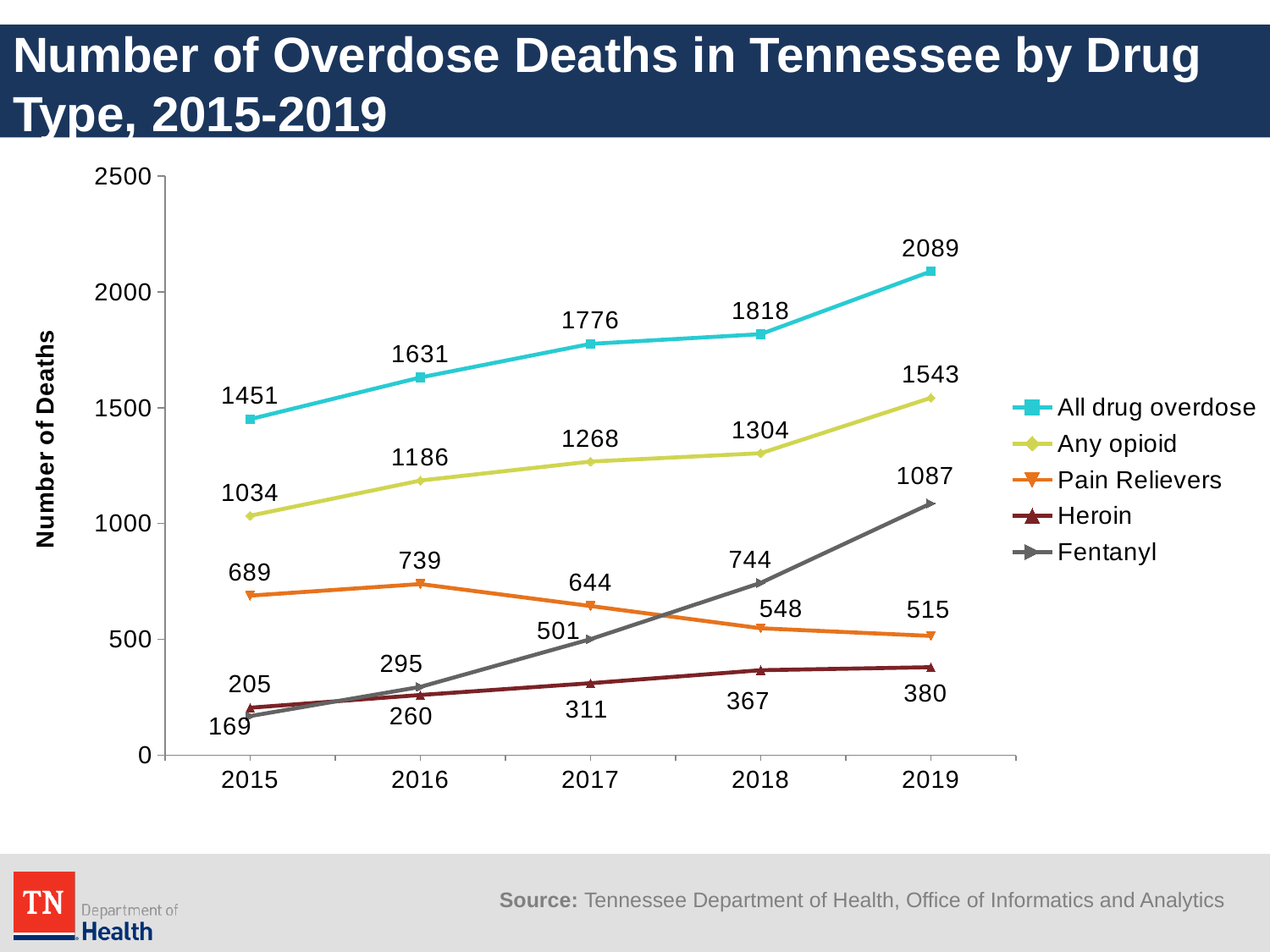
How many years are plotted along the x axis? 5 What was the number of heroin overdose deaths in 2015? 205 What type of chart is shown on the slide? Line chart What is the difference between any opioid deaths and pain reliever deaths in 2018? 756 What was the number of all drug overdose deaths in 2019? 2089 How many series does the legend list? 5 By how much did all drug overdose deaths increase from 2015 to 2019? 638 In which year were fentanyl overdose deaths lowest? 2015 In which year were pain reliever overdose deaths highest? 2016 Do fentanyl overdose deaths rise or fall from 2015 to 2019? Rise What was the number of fentanyl overdose deaths in 2017? 501 Which had more overdose deaths in 2019, pain relievers or heroin? Pain Relievers